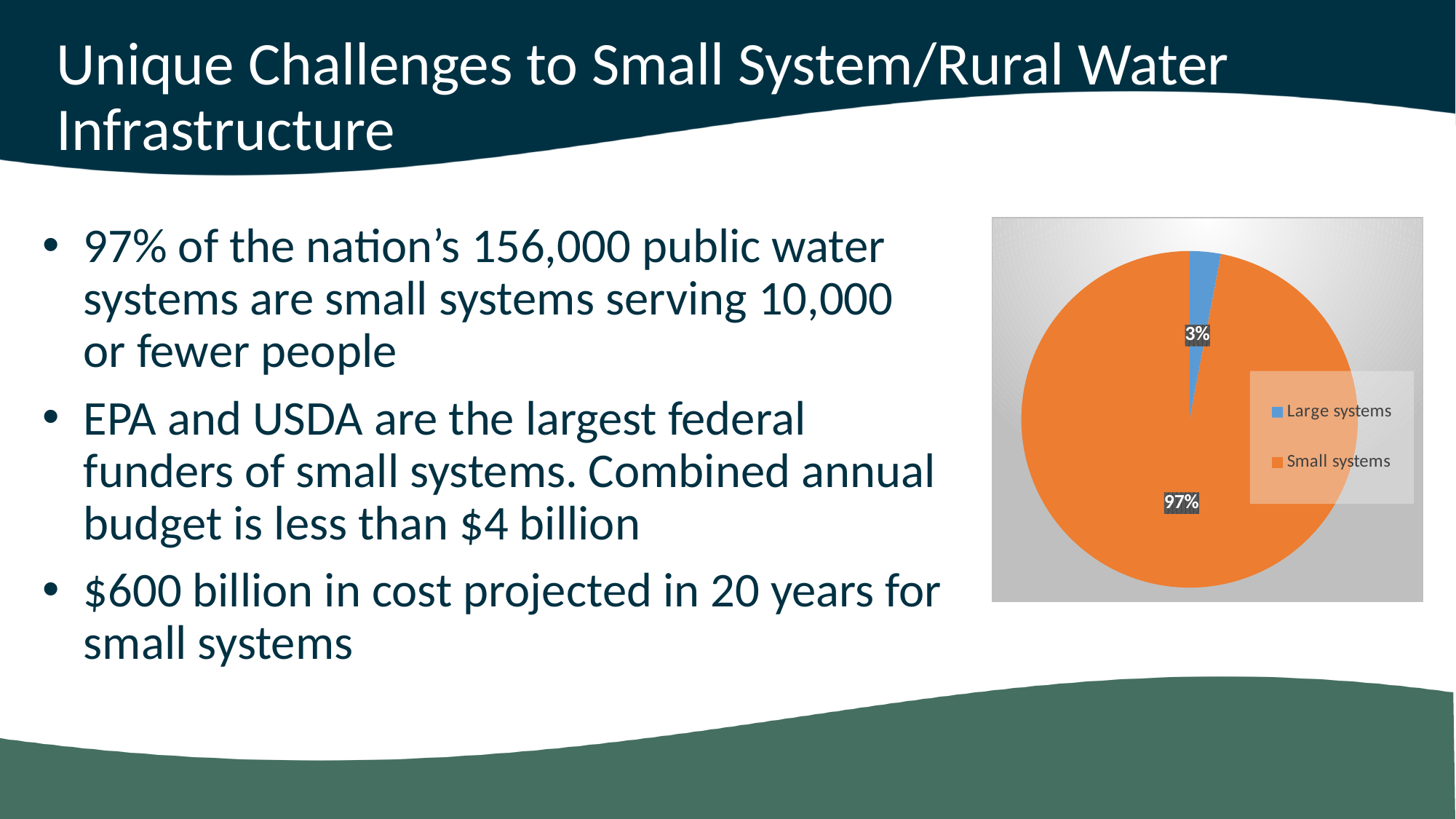
Which slice is larger, Large systems or Small systems? Small systems What kind of chart is shown on the slide? pie chart What colour is the Small systems slice? orange Which category has the smallest slice of the pie? Large systems Which category has the largest slice of the pie? Small systems What is the difference in percentage points between the Small systems and Large systems slices? 94 What share of the pie is Large systems? 3% What colour is the Large systems slice? blue How many categories does the pie chart show? 2 How many entries does the legend list? 2 What share of the pie is Small systems? 97%